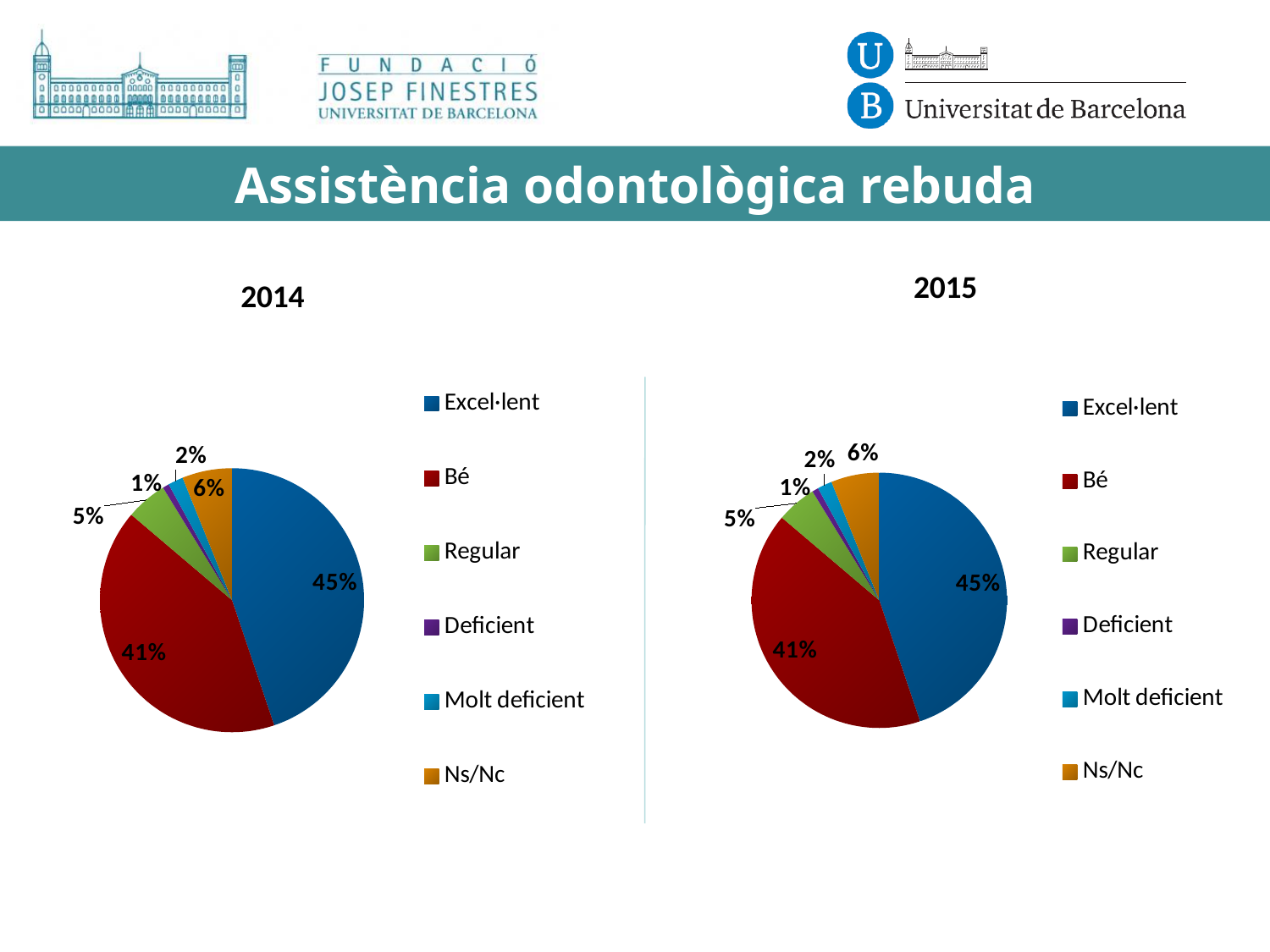
In the 2014 chart, what percentage is shown for Excel·lent? 45% In the 2015 chart, what percentage is shown for Molt deficient? 2% In the 2014 chart, which category has the largest share? Excel·lent In the 2014 chart, what is the difference between the Excel·lent and Bé shares? 4% How many categories does the legend of the 2014 chart list? 6 In the 2015 chart, what percentage is shown for Regular? 5% What is the title of the slide containing the two charts? Assistència odontològica rebuda In the 2015 chart, which category has the smallest share? Deficient What type of chart is used for the 2015 data? Pie chart In the 2015 chart, what percentage is shown for Bé? 41% In the 2014 chart, what percentage is shown for Ns/Nc? 6% In the 2015 chart, which is larger, Ns/Nc or Regular? Ns/Nc